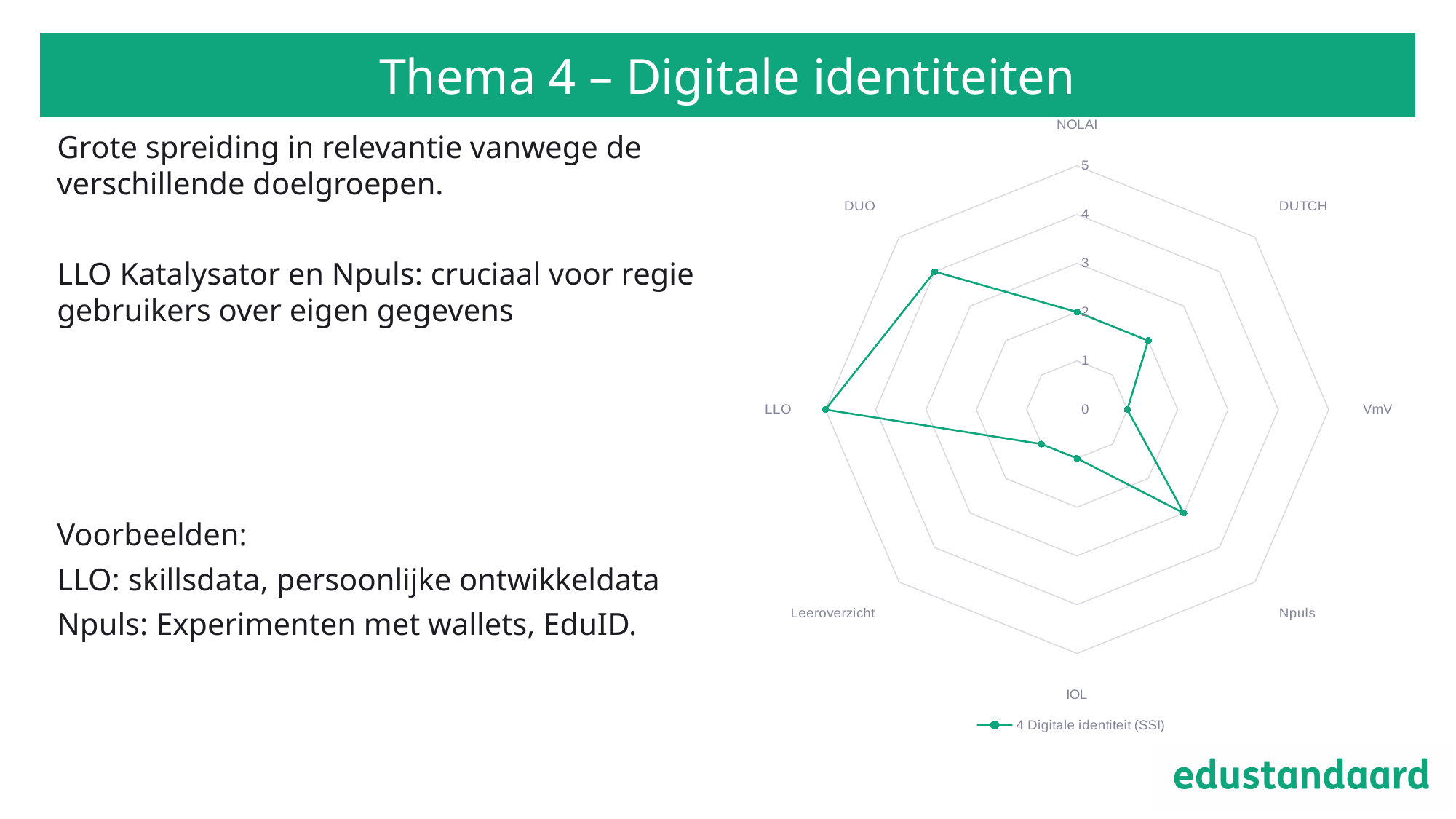
What is the maximum value shown on the radar chart's axis scale? 5 What kind of chart is shown on the slide? Radar chart Which has the larger value, DUO or DUTCH? DUO Which category has the highest value in the radar chart? LLO How many series does the legend of the radar chart list? 1 Is the value for LLO greater or less than 4? greater Which category has the lowest value in the radar chart? VmV, IOL and Leeroverzicht (tied at 1) Is the value for DUO greater or less than 3? greater Is the value for Npuls greater or less than 2? greater What is the name of the series shown in the legend of the radar chart? 4 Digitale identiteit (SSI) How many categories (axes) does the radar chart have? 8